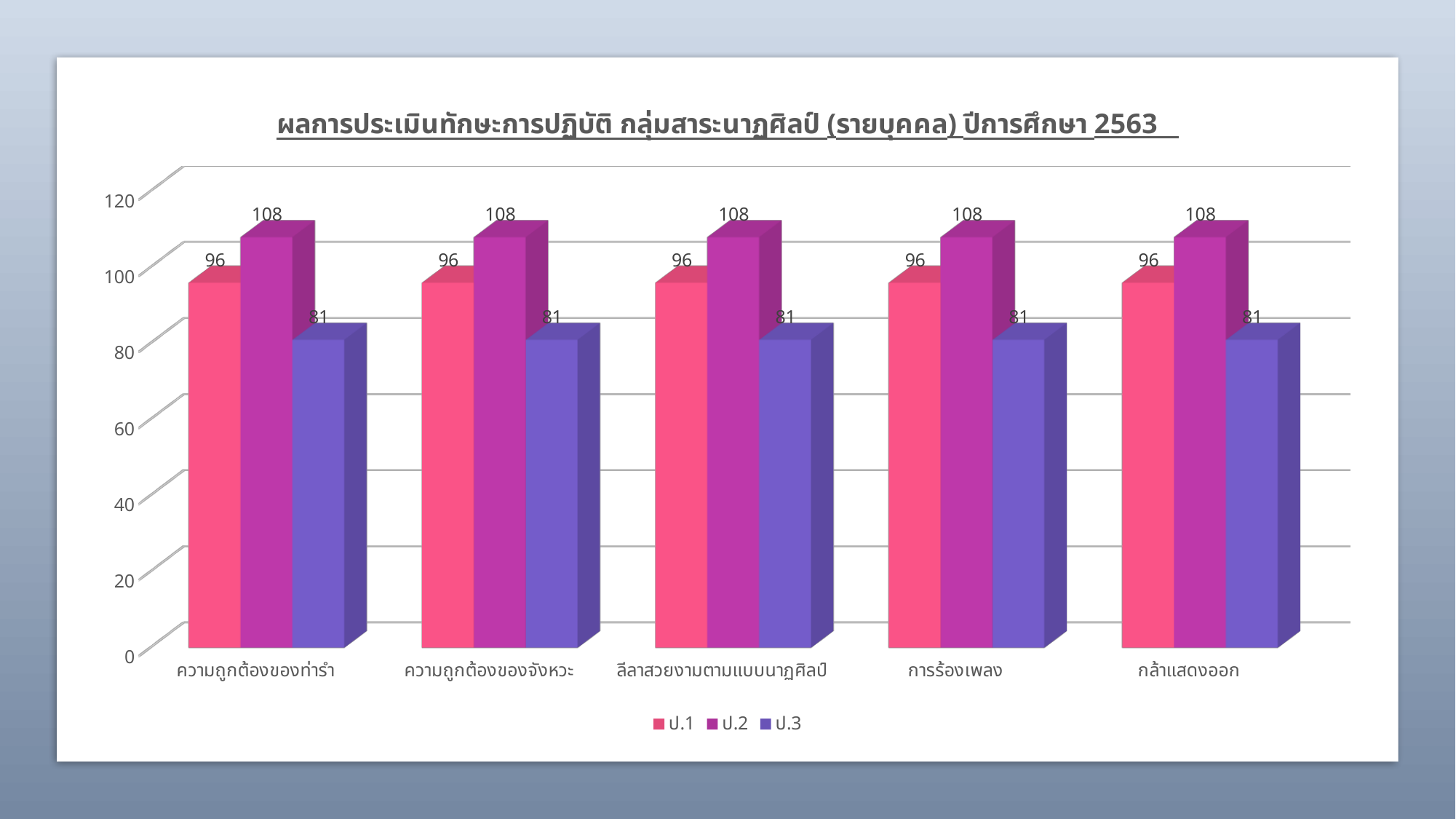
What is the value for ป.1 in the category ความถูกต้องของท่ารำ? 96 Which series has the lowest value in the category ความถูกต้องของจังหวะ? ป.3 What is the value for ป.3 in the category กล้าแสดงออก? 81 What is the difference between the ป.2 and ป.3 values in the category การร้องเพลง? 27 What is the difference between the ป.2 and ป.1 values in the category กล้าแสดงออก? 12 How many categories are shown on the x axis? 5 What kind of chart is shown on the slide? bar chart How many series does the legend list? 3 What is the value for ป.2 in the category การร้องเพลง? 108 In the category ความถูกต้องของท่ารำ, which is larger: the value for ป.1 or the value for ป.3? ป.1 Which series has the highest value in the category ลีลาสวยงามตามแบบนาฏศิลป์? ป.2 Is the value for ป.2 in the category ความถูกต้องของจังหวะ greater or less than 100? greater